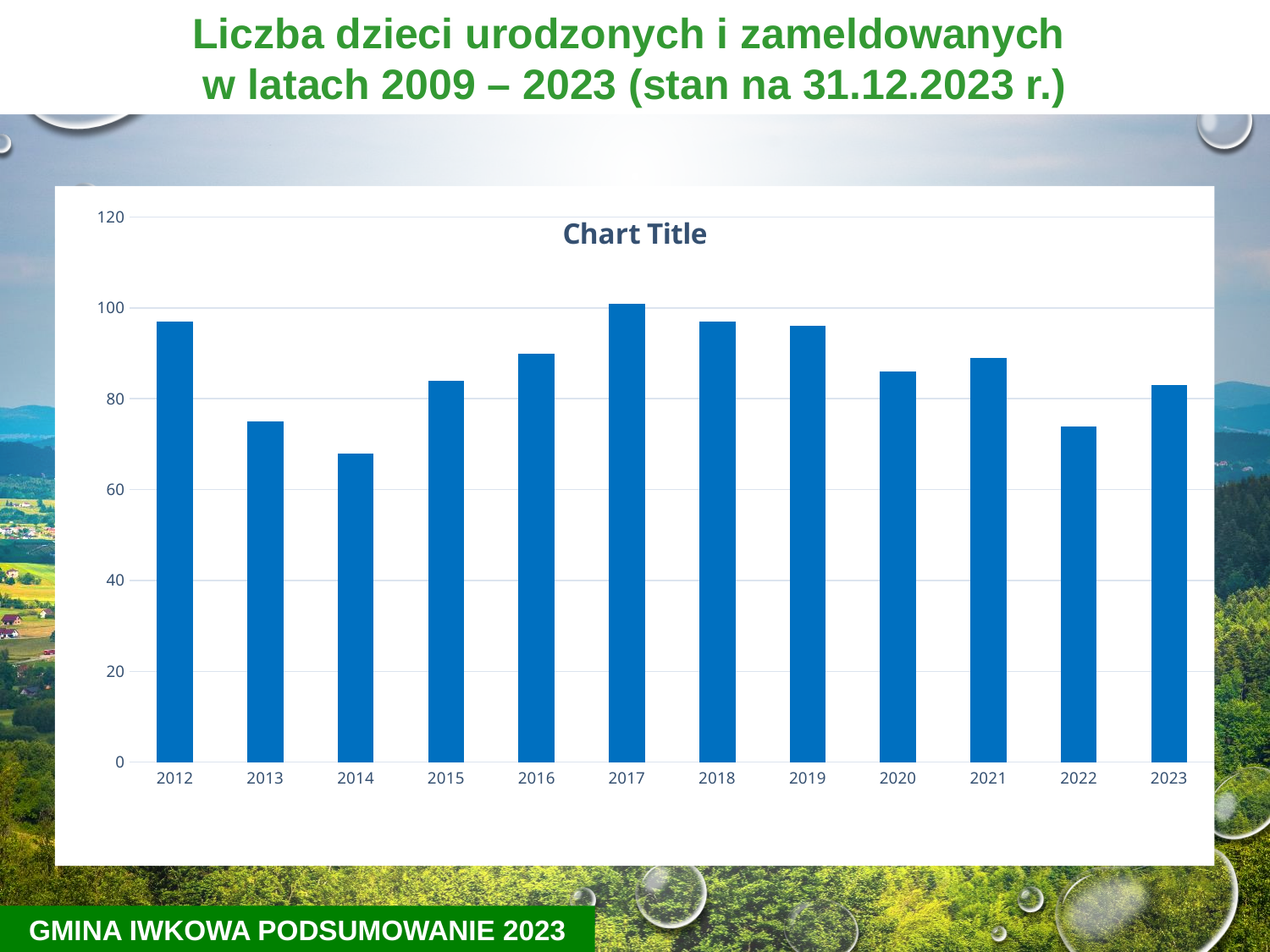
What kind of chart is shown on the slide? bar chart Do the values rise or fall from 2014 to 2017? rise How many years are shown on the x axis of the chart? 12 Is the value for 2016 greater or less than 80? greater What title is printed inside the chart area? Chart Title Which year has the larger value, 2015 or 2016? 2016 Is the value for 2014 greater or less than 80? less Is the value for 2022 greater or less than 80? less Which year has the lowest bar in the chart? 2014 Which year has the larger value, 2013 or 2014? 2013 Which year has the highest bar in the chart? 2017